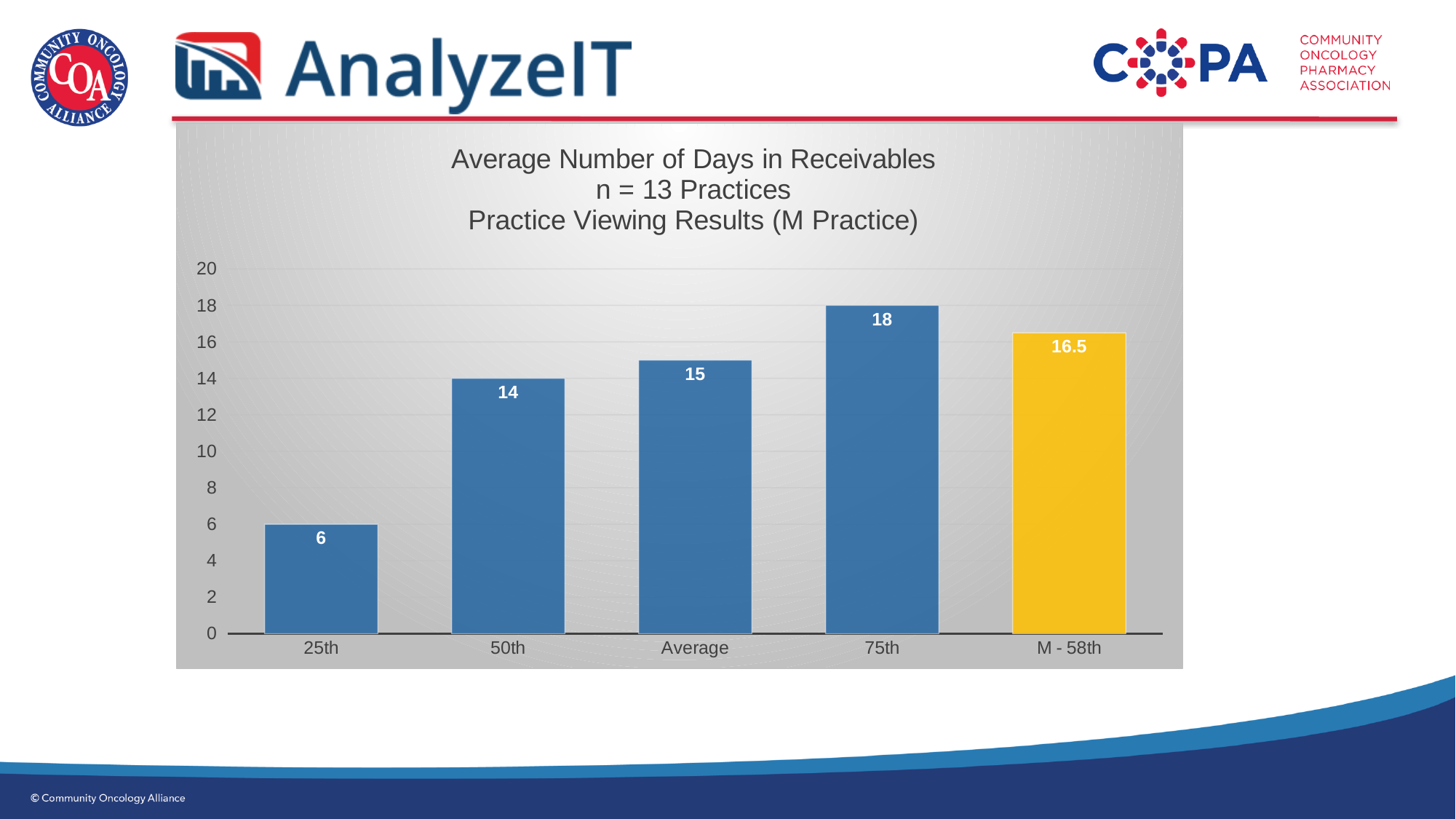
Which is larger, the value for Average or the value for M - 58th? M - 58th How many categories are shown on the x axis? 5 What is the difference between the values for 75th and M - 58th? 1.5 What kind of chart is shown on the slide? Bar chart What is the value for the M - 58th category? 16.5 What is the value for the 25th category? 6 Which category has the highest value? 75th What is the value for the 75th category? 18 What is the value for the Average category? 15 What is the value for the 50th category? 14 Which category has the lowest value? 25th Which bar is coloured yellow rather than blue? M - 58th